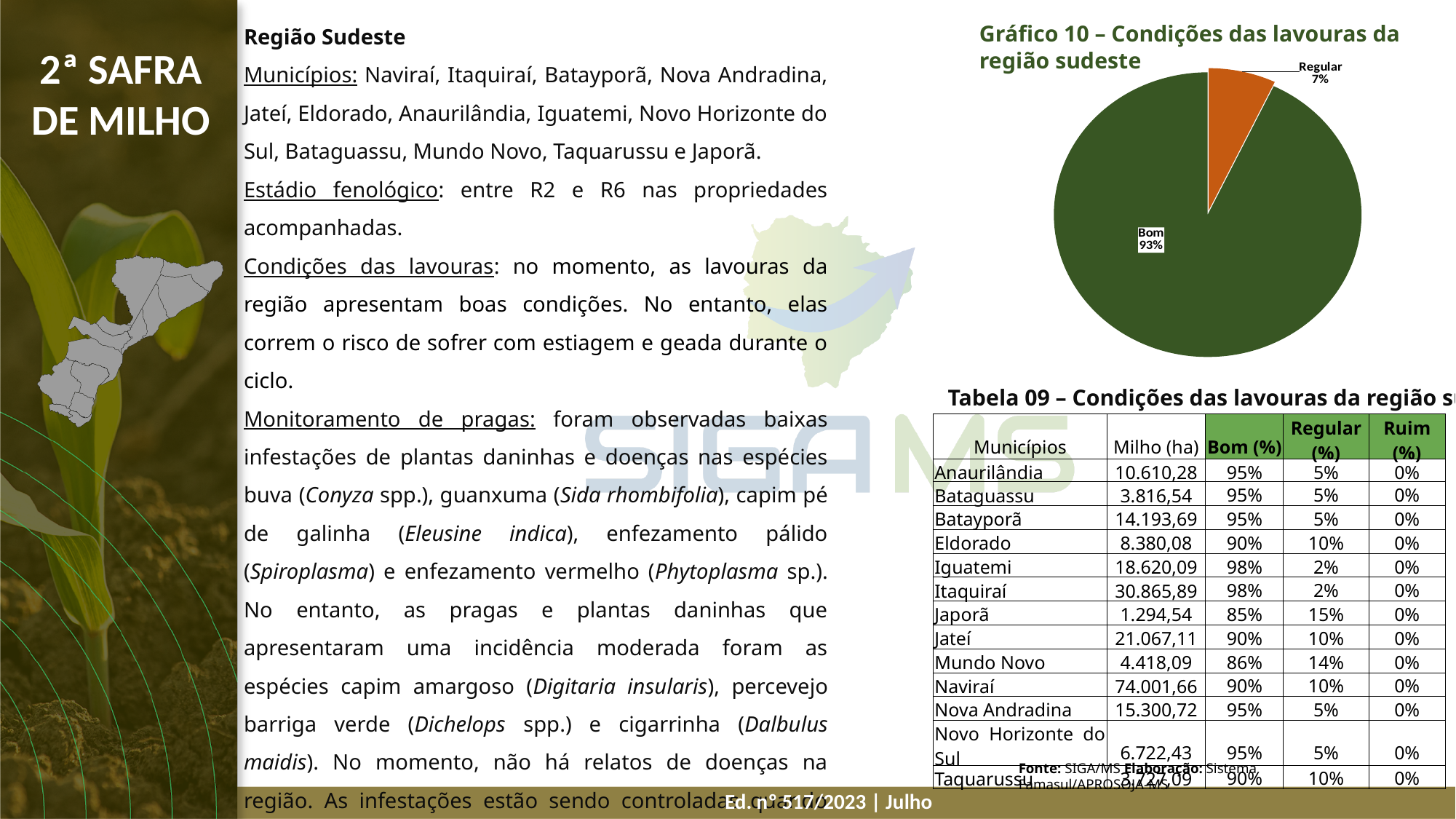
In Gráfico 10, what colour is the 'Bom' slice? dark green In Gráfico 10, what share of the crops is in the 'Regular' condition? 7% In Gráfico 10, what is the difference in percentage points between the 'Bom' and 'Regular' slices? 86 percentage points In Gráfico 10, what share of the crops is in the 'Bom' condition? 93% How many slices does the pie chart in Gráfico 10 have? 2 In Gráfico 10, which category has the largest slice? Bom What kind of chart is Gráfico 10? pie chart In Gráfico 10, which is larger: the 'Bom' slice or the 'Regular' slice? Bom What is the title of the pie chart on the slide? Gráfico 10 – Condições das lavouras da região sudeste In Gráfico 10, which category has the smallest slice? Regular